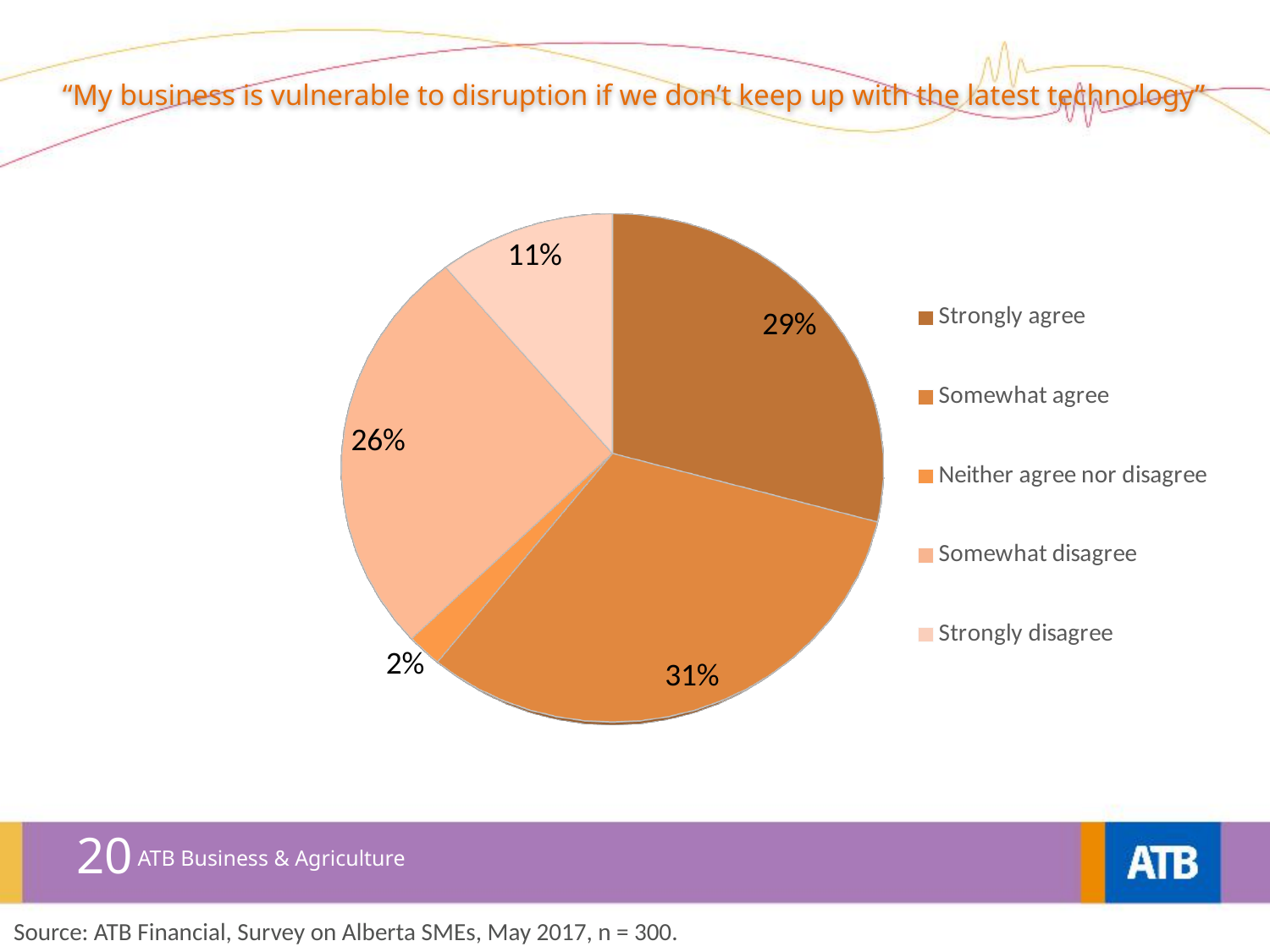
Which response category has the smallest share of the pie? Neither agree nor disagree What percentage of respondents answered "Somewhat agree"? 31% What kind of chart is shown on the slide? Pie chart What percentage of respondents answered "Strongly agree"? 29% What percentage of respondents answered "Neither agree nor disagree"? 2% What statement were respondents asked to rate, according to the chart title? "My business is vulnerable to disruption if we don't keep up with the latest technology" What is the difference in percentage points between "Somewhat agree" and "Strongly agree"? 2 percentage points What percentage of respondents answered "Strongly disagree"? 11% How many response categories does the legend list? 5 Which is larger, the share for "Somewhat disagree" or the share for "Strongly disagree"? Somewhat disagree Which response category has the largest share of the pie? Somewhat agree What percentage of respondents answered "Somewhat disagree"? 26%